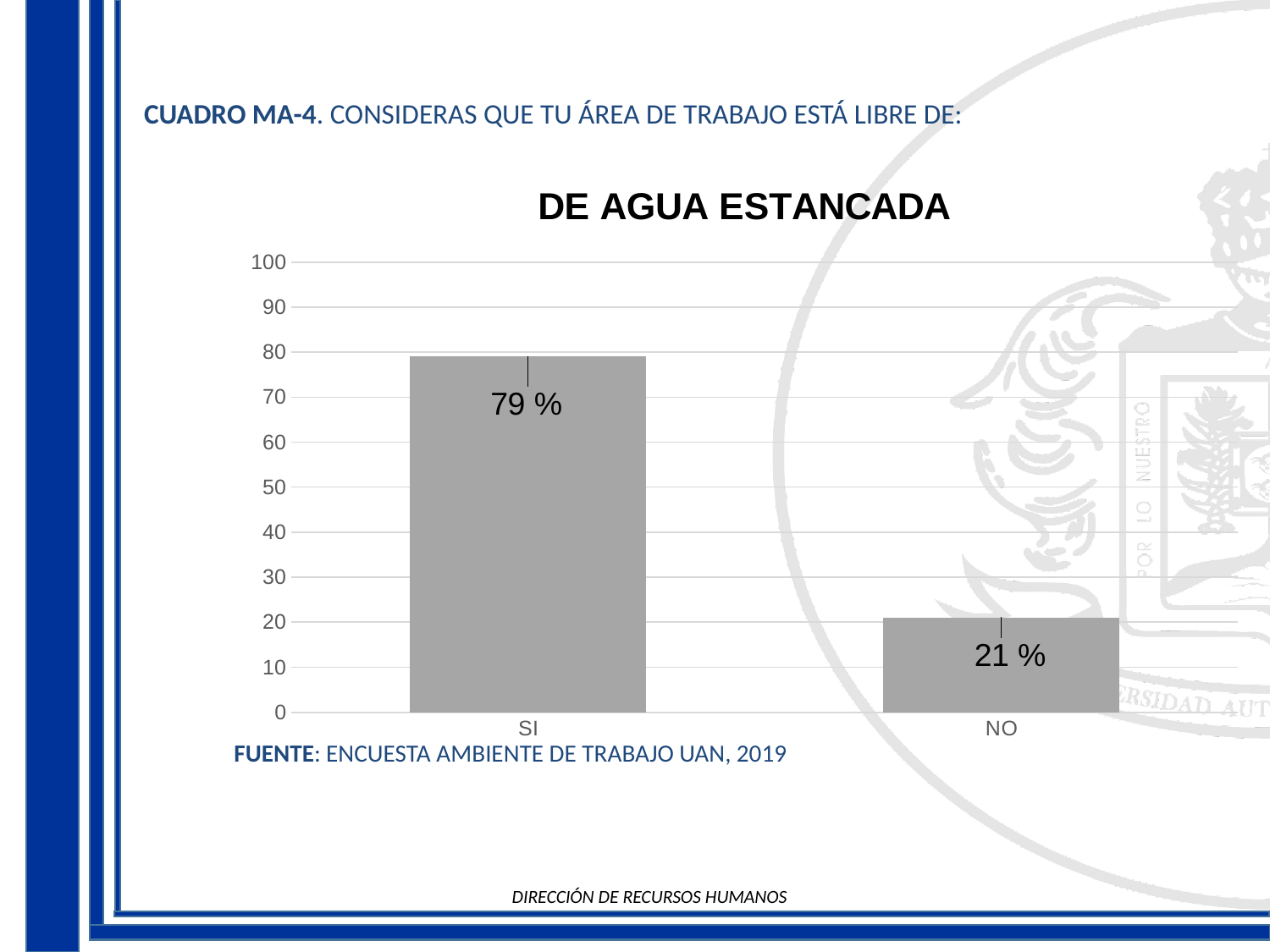
What is the value for NO? 21 % Is the value for NO greater or less than 30? less What is the value for SI? 79 % Which is larger, the value for SI or the value for NO? SI What is the difference between the values for SI and NO? 58 % Which category has the highest value? SI What is the title of the chart? DE AGUA ESTANCADA What is the highest value shown on the y axis? 100 How many categories are shown on the x axis? 2 Which category has the lowest value? NO What kind of chart is shown? bar chart Is the value for SI greater or less than 70? greater